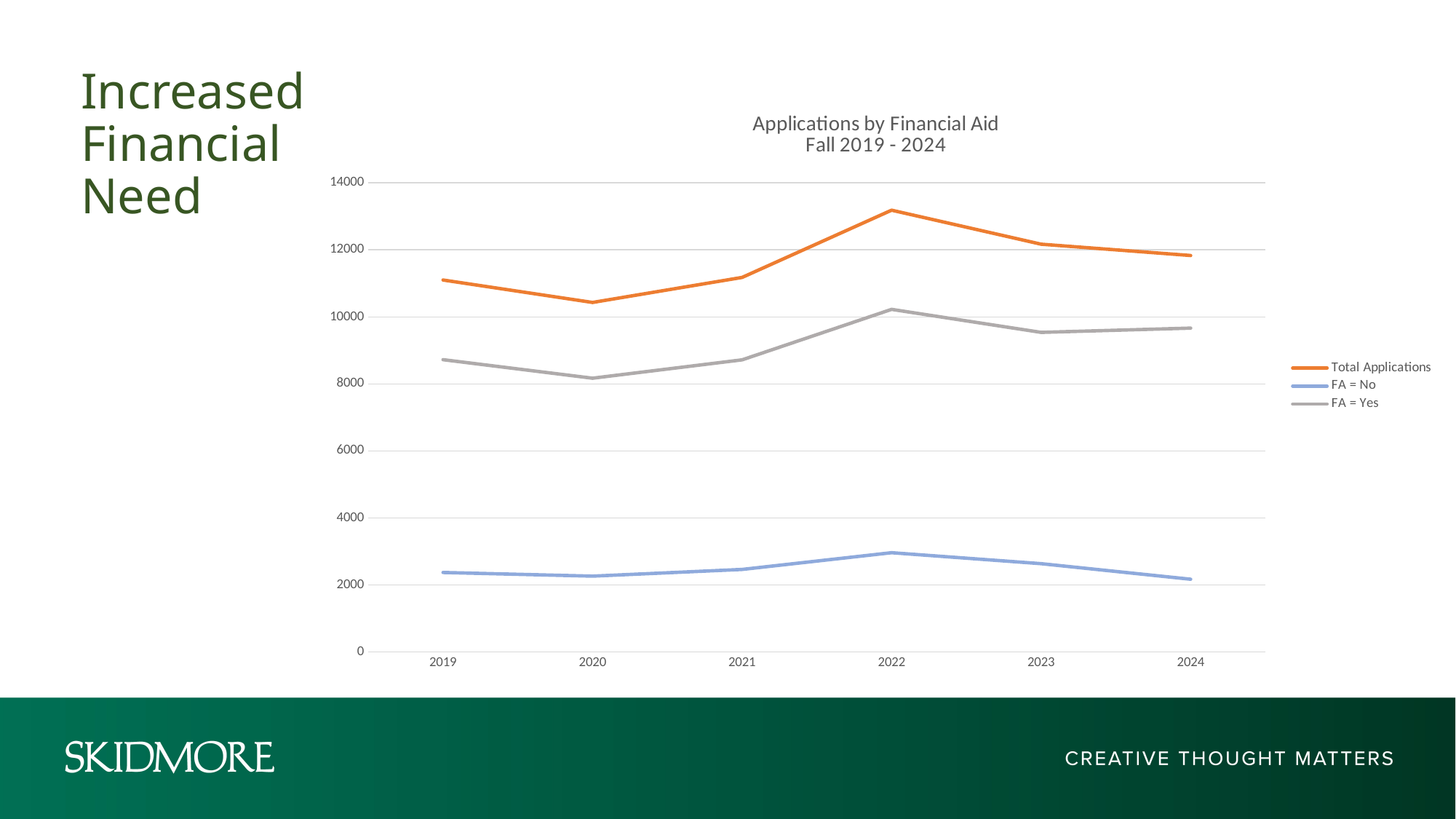
How many series does the legend list? 3 Do Total Applications rise or fall from 2022 to 2024? fall Which is larger, Total Applications in 2023 or Total Applications in 2024? 2023 In which year is Total Applications highest? 2022 Is the value for FA = No in 2022 greater or less than 4000? less Is the value for FA = Yes in 2023 greater or less than 10000? less What kind of chart is shown on the slide? line chart In which year is FA = Yes highest? 2022 How many years are plotted along the x axis? 6 In which year is FA = No highest? 2022 In which year is Total Applications lowest? 2020 Is the value for Total Applications in 2022 greater or less than 12000? greater